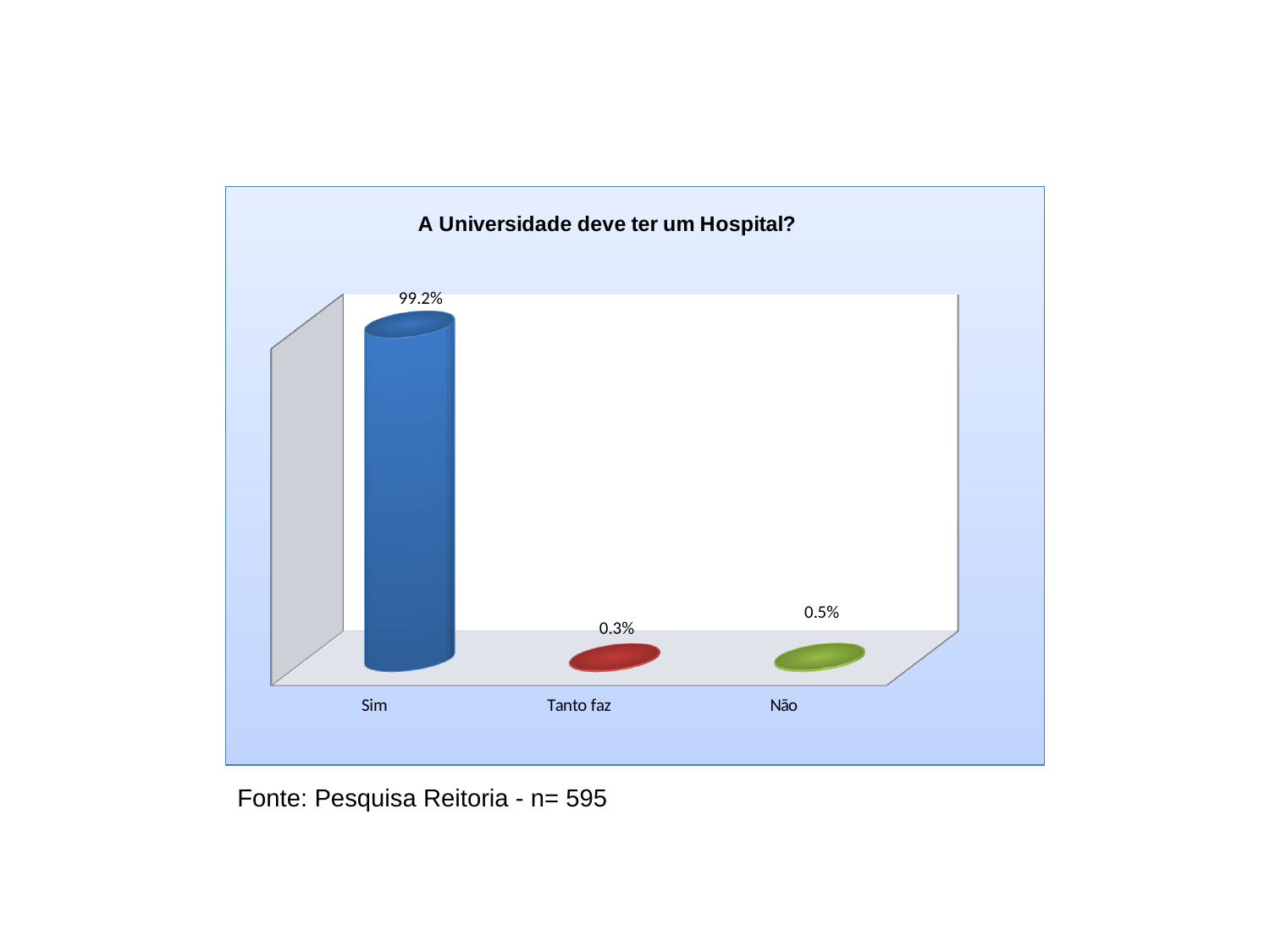
What is the value for Sim? 99.2% How many categories are shown in the chart? 3 What is the difference between the values for Sim and Não? 98.7% What is the value for Tanto faz? 0.3% What is the value for Não? 0.5% What kind of chart is shown on the slide? Bar chart What colour is the bar for Sim? Blue Which category has the highest value? Sim What is the difference between the values for Não and Tanto faz? 0.2% Which is larger, the value for Não or the value for Tanto faz? Não What is the title of the chart? A Universidade deve ter um Hospital? Which category has the lowest value? Tanto faz